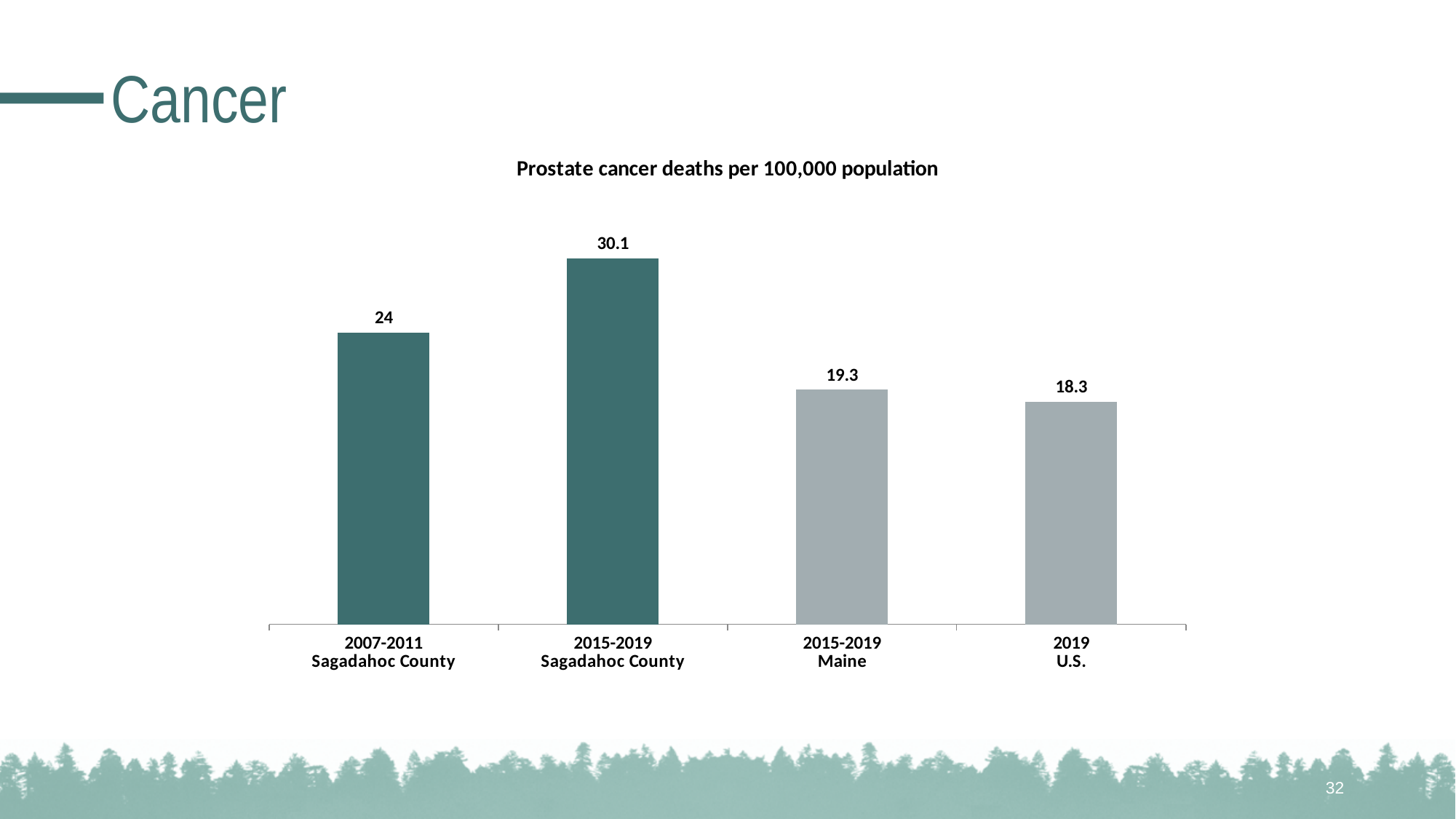
What kind of chart is shown on the slide? Bar chart What is the prostate cancer death rate per 100,000 population for Maine in 2015-2019? 19.3 Which is larger, the 2015-2019 Sagadahoc County rate or the 2015-2019 Maine rate? 2015-2019 Sagadahoc County Which category has the lowest prostate cancer death rate? 2019 U.S. What is the difference between the 2015-2019 Maine rate and the 2019 U.S. rate? 1 What is the prostate cancer death rate per 100,000 population for Sagadahoc County in 2015-2019? 30.1 What is the prostate cancer death rate per 100,000 population for the U.S. in 2019? 18.3 What is the title of the chart? Prostate cancer deaths per 100,000 population How many bars are shown in the chart? 4 Which category has the highest prostate cancer death rate? 2015-2019 Sagadahoc County What is the difference between the Sagadahoc County prostate cancer death rate in 2015-2019 and in 2007-2011? 6.1 What is the prostate cancer death rate per 100,000 population for Sagadahoc County in 2007-2011? 24